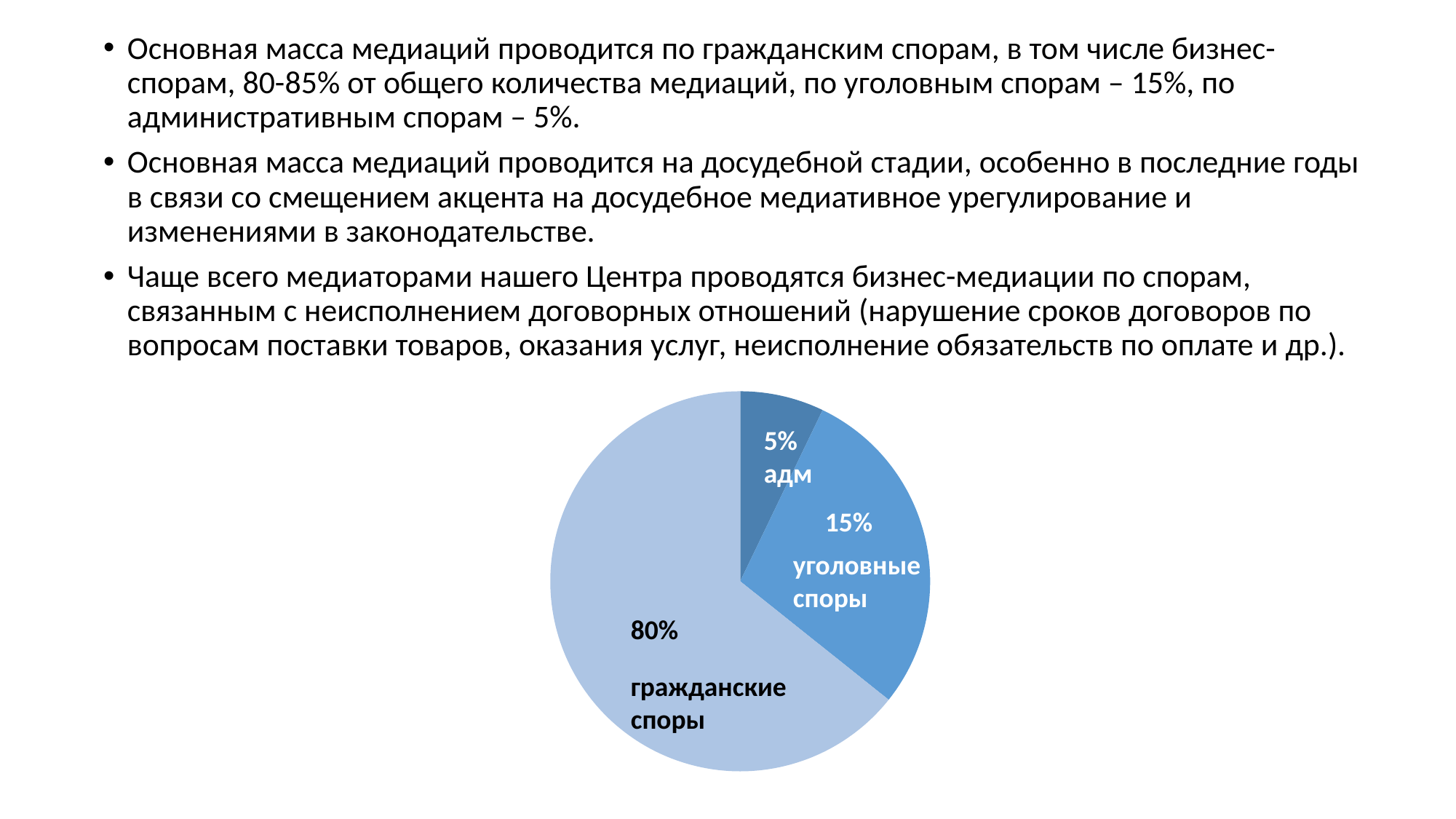
Which is larger: the share for "уголовные споры" or the share for "адм"? уголовные споры What share of the pie is labelled "уголовные споры"? 15% What is the combined share of "уголовные споры" and "адм"? 20% Which slice of the pie chart is the smallest? адм Which slice of the pie chart is the largest? гражданские споры What share of the pie is labelled "гражданские споры"? 80% What kind of chart is shown on the slide? pie chart What is the difference between the shares for "гражданские споры" and "уголовные споры"? 65% Which slice of the pie chart is drawn in the lightest shade of blue? гражданские споры What is the difference between the shares for "уголовные споры" and "адм"? 10% What share of the pie is labelled "адм"? 5% How many slices does the pie chart have? 3